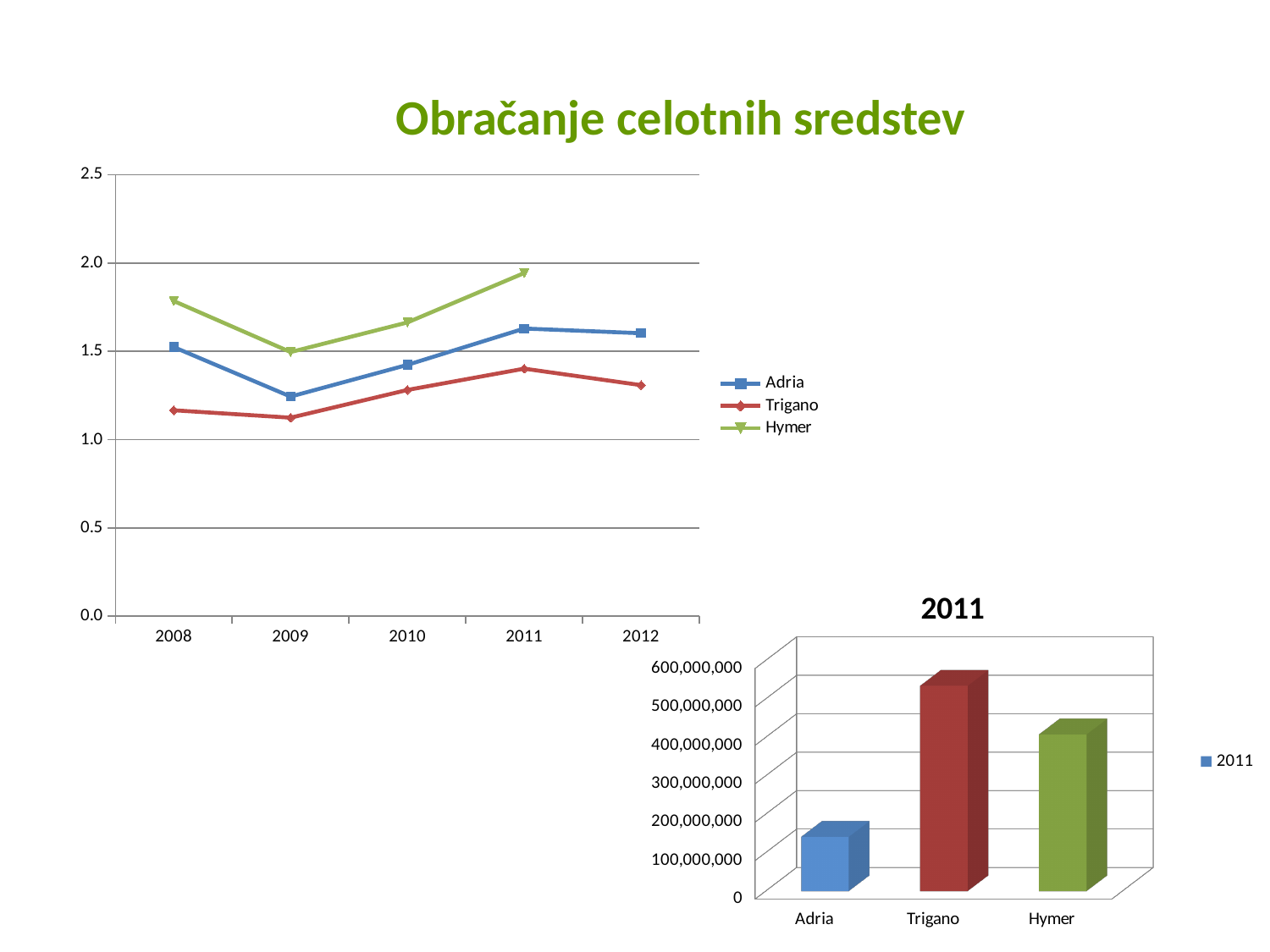
In the line chart titled 'Obračanje celotnih sredstev', which series has the highest value in 2011? Hymer In the chart titled '2011', which company has the highest bar? Trigano What kind of chart is the chart titled '2011'? bar chart In the line chart titled 'Obračanje celotnih sredstev', which series has the lowest value in 2008? Trigano In the line chart titled 'Obračanje celotnih sredstev', is the value for Adria in 2009 greater or less than 1.5? less In the line chart titled 'Obračanje celotnih sredstev', is the value for Trigano in 2009 greater or less than 1.5? less In the line chart titled 'Obračanje celotnih sredstev', does the Hymer series rise or fall from 2009 to 2011? rise In the chart titled '2011', is the value for Adria greater or less than 200,000,000? less In the line chart titled 'Obračanje celotnih sredstev', how many years are shown on the x axis? 5 In the chart titled '2011', which company has the lowest bar? Adria In the line chart titled 'Obračanje celotnih sredstev', how many series does the legend list? 3